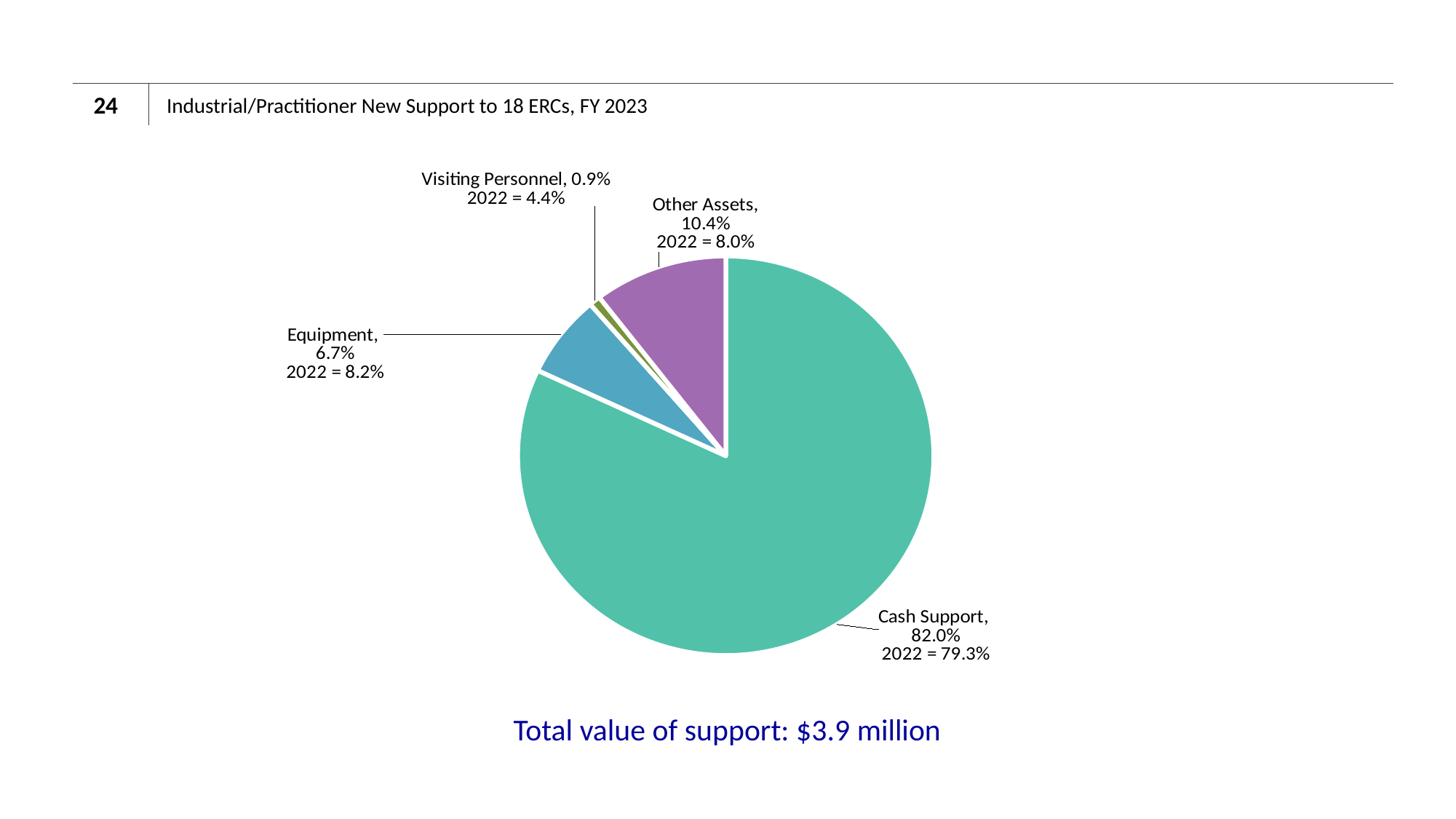
Which category has the largest slice of the pie? Cash Support What is the difference between the FY 2023 percentages for Other Assets and Equipment? 3.7% What share of the pie does Cash Support represent in FY 2023? 82.0% What is the FY 2023 percentage for Visiting Personnel? 0.9% Which category has the smallest slice of the pie? Visiting Personnel What was the 2022 percentage for Visiting Personnel? 4.4% What is the FY 2023 percentage for Equipment? 6.7% How many slices does the pie chart have? 4 What was the 2022 percentage for Cash Support? 79.3% What kind of chart is shown on the slide? pie chart What is the total value of support stated on the slide? $3.9 million What is the FY 2023 percentage for Other Assets? 10.4%